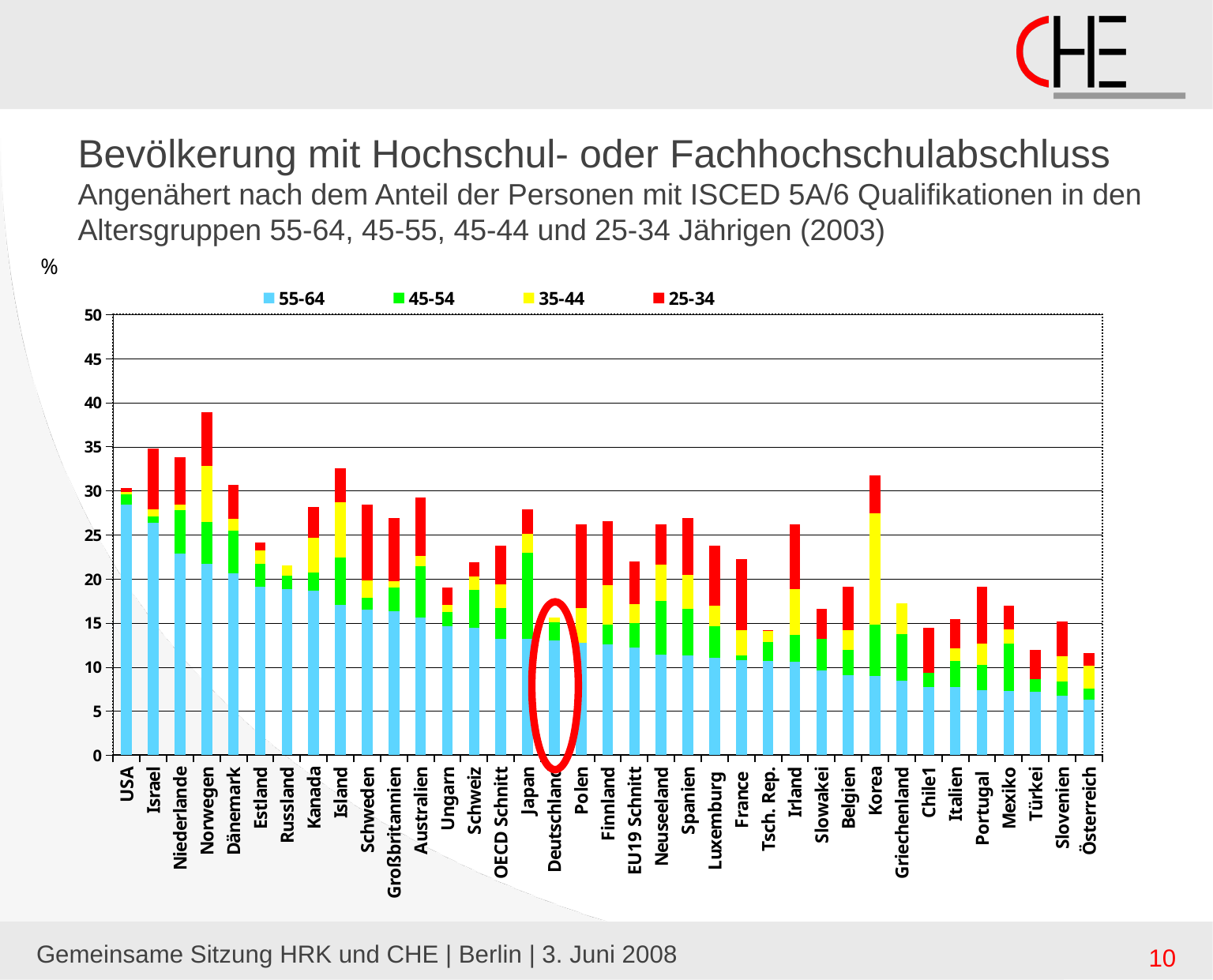
Which age groups are listed in the legend? 55-64, 45-54, 35-44, 25-34 Do the 55-64 values generally rise or fall from left to right along the x axis? fall How many series does the legend list? 4 Which country is highlighted with a red circle on the chart? Deutschland Is the total stacked value for Norwegen greater or less than 35? greater Which country has the highest total stacked bar? Norwegen Which has the larger total stacked bar, Israel or Österreich? Israel Is the total stacked value for Deutschland greater or less than 20? less Is the 55-64 value for USA greater or less than 25? greater What kind of chart is shown on the slide? stacked bar chart How many countries or regions are shown on the x axis? 37